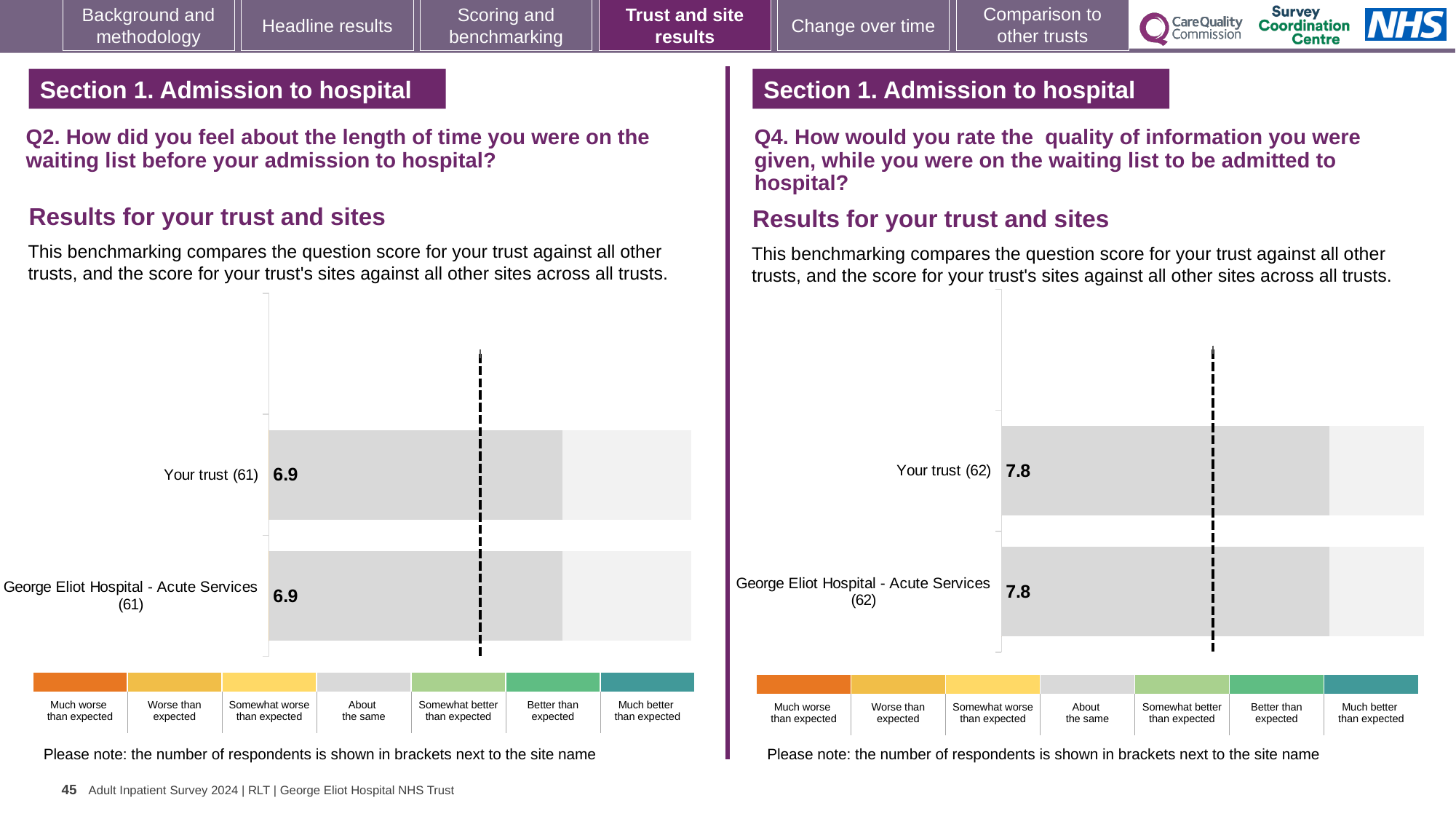
In the Q2 chart on the left, how many respondents are shown in brackets next to Your trust? 61 How many bars are plotted in the Q2 chart on the left? 2 What kind of chart is the Q2 chart on the left? Bar chart What kind of chart is the Q4 chart on the right? Bar chart In the Q4 chart on the right, what is the score for Your trust? 7.8 In the Q2 chart on the left, what is the score for George Eliot Hospital - Acute Services? 6.9 What is the difference between the Your trust score in the Q4 chart on the right and the Your trust score in the Q2 chart on the left? 0.9 In the Q4 chart on the right, how many respondents are shown in brackets next to George Eliot Hospital - Acute Services? 62 Which is larger: the Your trust score in the Q2 chart on the left or the Your trust score in the Q4 chart on the right? Q4 chart on the right In the Q2 chart on the left, what is the score for Your trust? 6.9 In the Q4 chart on the right, what is the score for George Eliot Hospital - Acute Services? 7.8 How many bars are plotted in the Q4 chart on the right? 2